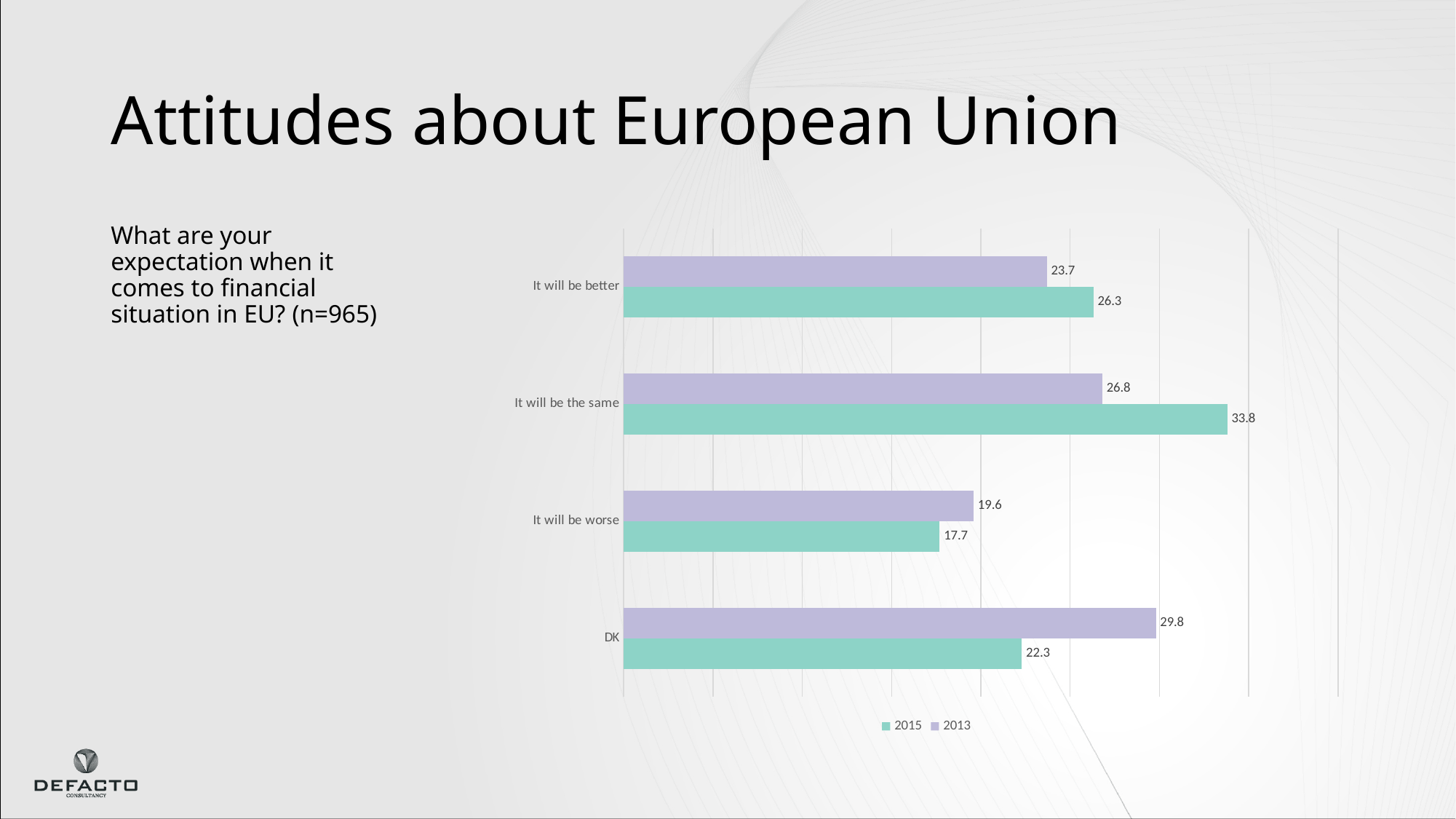
How many series does the legend list? 2 What kind of chart is shown on the slide? Bar chart Which category has the lowest 2013 value? It will be worse What is the 2015 value for "It will be worse"? 17.7 What is the 2015 value for "It will be the same"? 33.8 What is the 2013 value for "DK"? 29.8 What is the 2013 value for "It will be better"? 23.7 What is the difference between the 2015 and 2013 values for "It will be the same"? 7.0 Which category has the highest 2015 value? It will be the same How many categories are shown on the chart? 4 What is the difference between the 2013 and 2015 values for "DK"? 7.5 For "It will be worse", which year has the larger value, 2013 or 2015? 2013